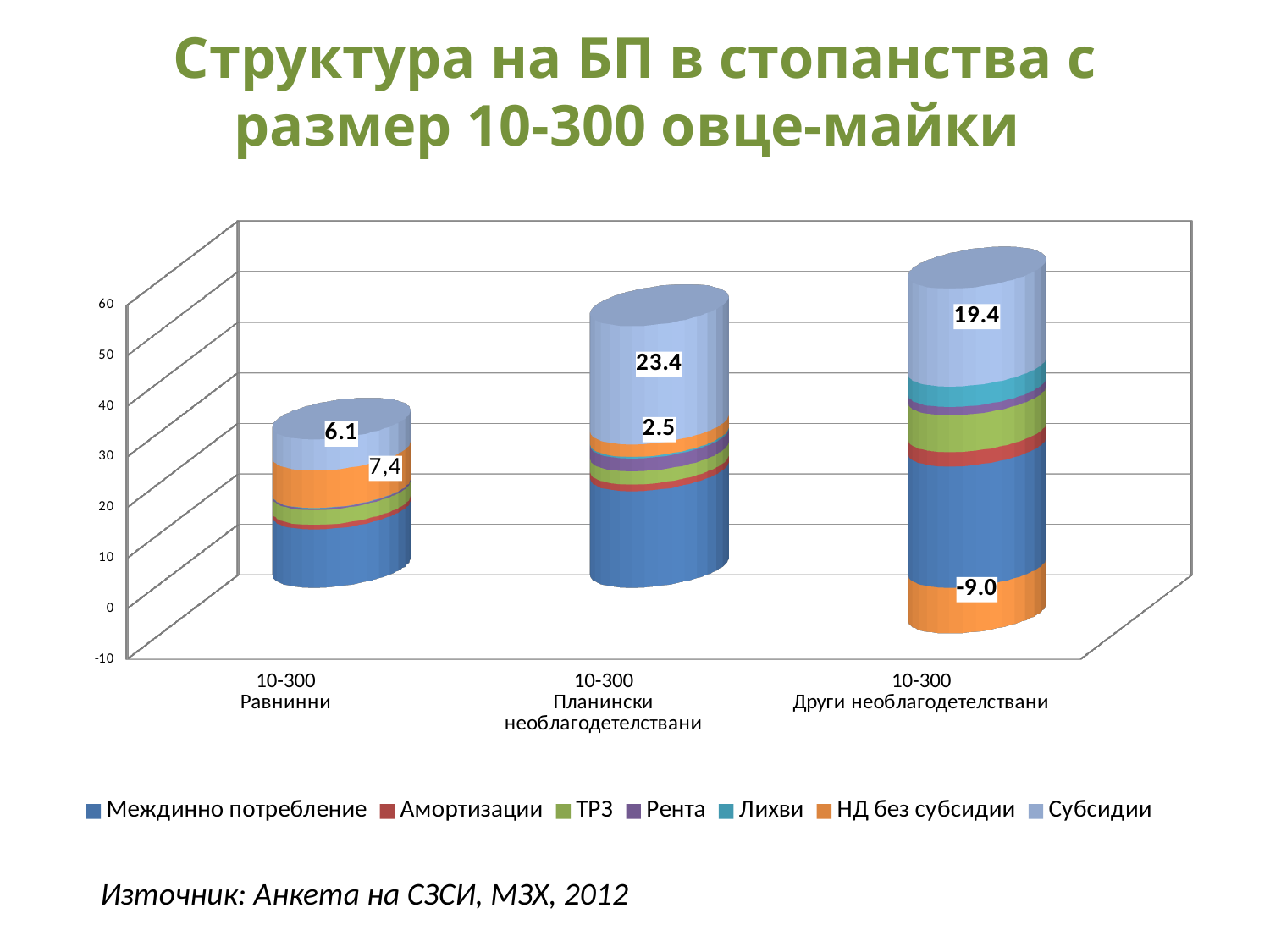
What is the value of НД без субсидии for 10-300 Планински необлагодетелствани? 2.5 What is the first series listed in the chart legend? Междинно потребление Which category has the highest value of Субсидии? 10-300 Планински необлагодетелствани What is the value of НД без субсидии for 10-300 Други необлагодетелствани? -9.0 Which is larger: the Субсидии value for 10-300 Равнинни or for 10-300 Други необлагодетелствани? 10-300 Други необлагодетелствани What is the value of Субсидии for 10-300 Планински необлагодетелствани? 23.4 What is the value of Субсидии for 10-300 Равнинни? 6.1 What kind of chart is shown on the slide? Stacked bar chart How many series does the legend list? 7 What is the difference between the Субсидии values for 10-300 Планински необлагодетелствани and 10-300 Други необлагодетелствани? 4.0 What is the value of Субсидии for 10-300 Други необлагодетелствани? 19.4 How many categories are shown on the x axis of the chart? 3